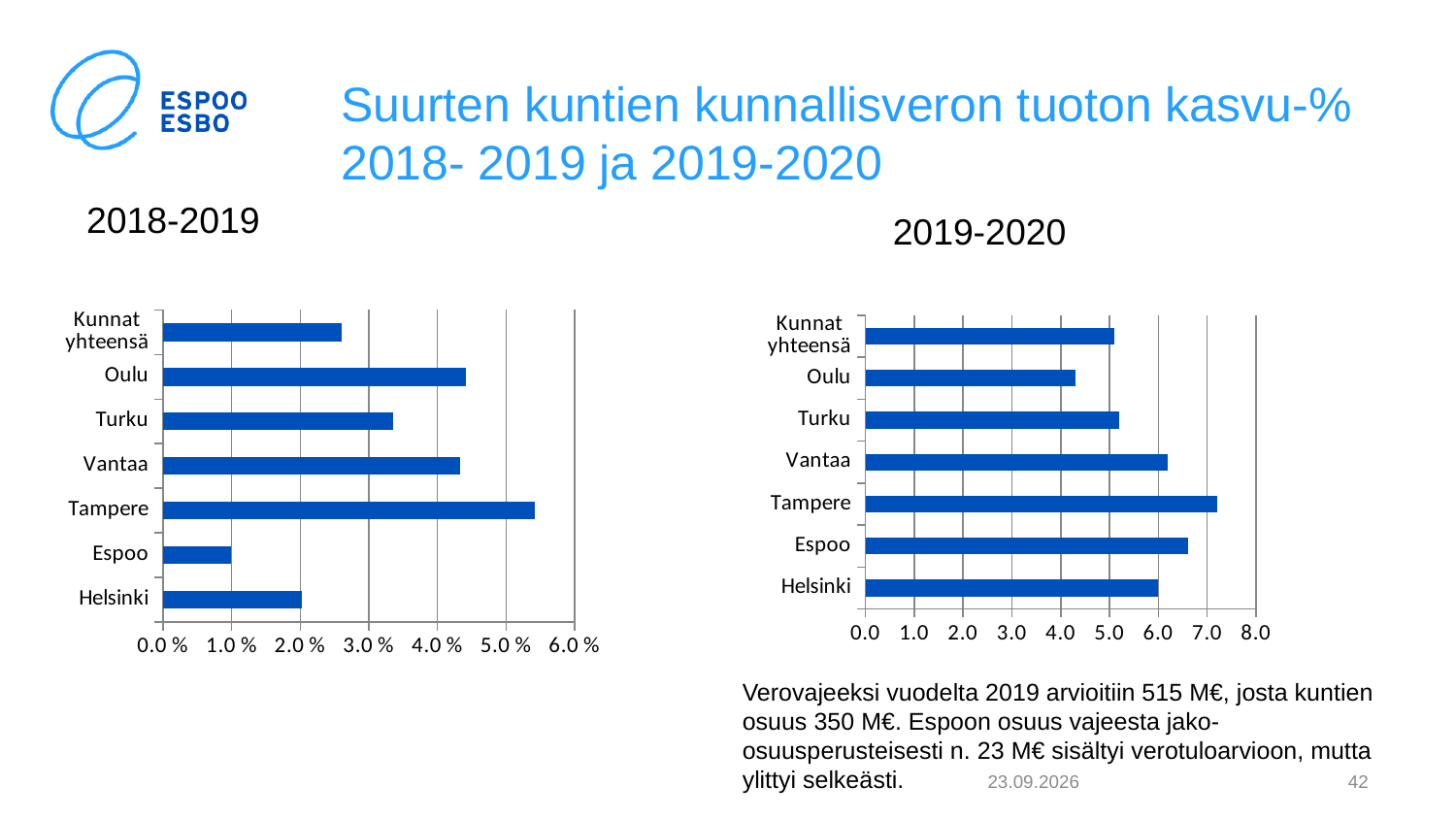
How many categories are shown in the 2019-2020 chart? 7 In the 2019-2020 chart, is the value for Oulu greater or less than 5.0? less In the 2018-2019 chart, is the value for Tampere greater or less than 5.0%? greater In the 2019-2020 chart, is the value for Espoo greater or less than 6.0? greater In the 2018-2019 chart, which municipality has the highest value? Tampere In the 2019-2020 chart, which municipality has the highest value? Tampere In the 2019-2020 chart, which is larger, the value for Espoo or the value for Helsinki? Espoo What kind of chart is the 2018-2019 chart? bar chart In the 2018-2019 chart, which municipality has the lowest value? Espoo In the 2019-2020 chart, which municipality has the lowest value? Oulu In the 2018-2019 chart, which is larger, the value for Turku or the value for Tampere? Tampere